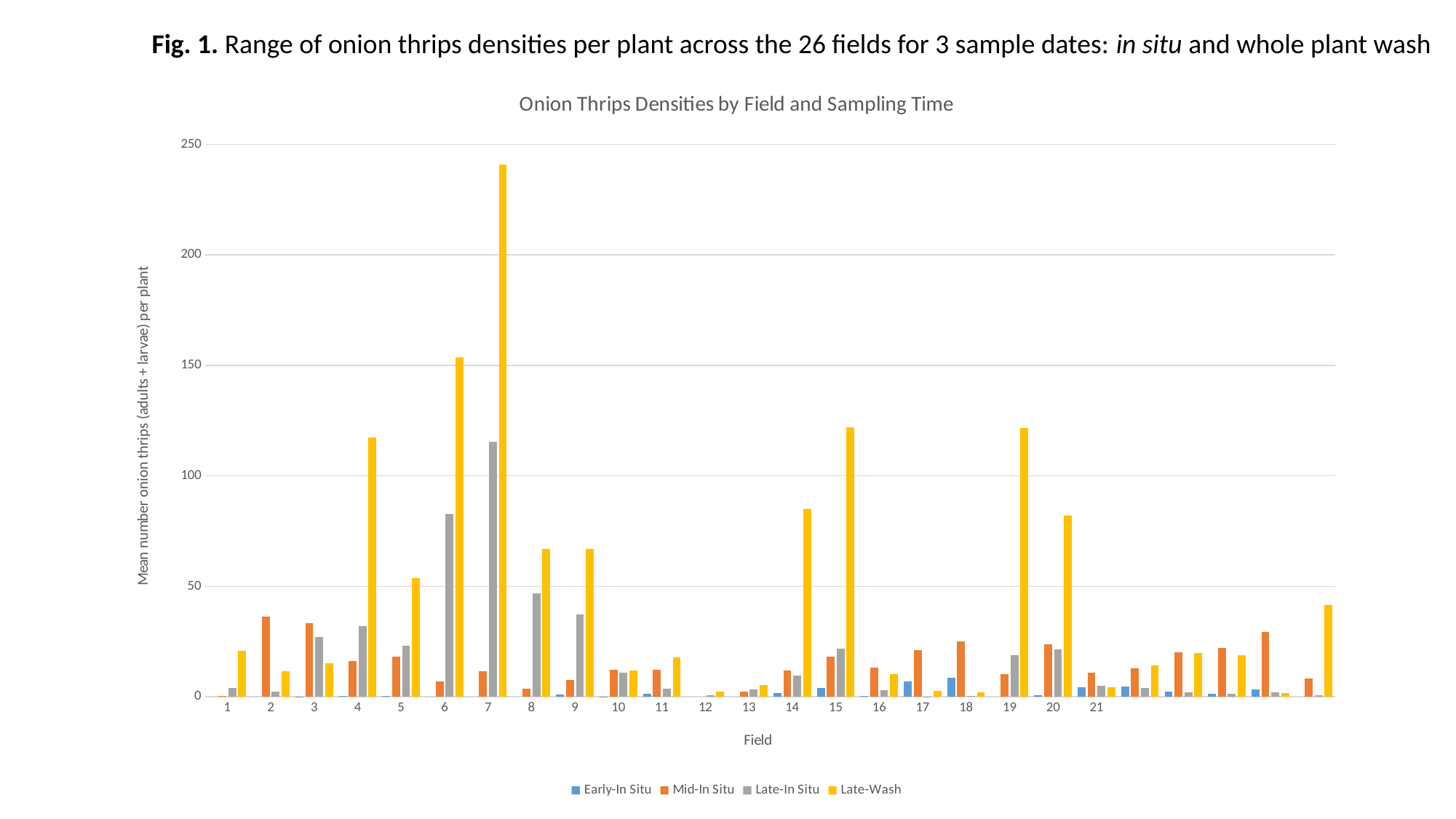
Which field has the highest Late-Wash value? 7 Is the Late-Wash value for field 8 greater or less than 50? greater Is the Late-In Situ value for field 7 greater or less than 100? greater What is the label of the x axis? Field Which is larger, the Late-In Situ value for field 7 or for field 6? Field 7 What is the title of the chart? Onion Thrips Densities by Field and Sampling Time Is the Late-In Situ value for field 6 greater or less than 100? less Which is larger, the Late-Wash value for field 4 or for field 5? Field 4 How many series does the legend list? 4 What kind of chart is shown on the slide? Bar chart